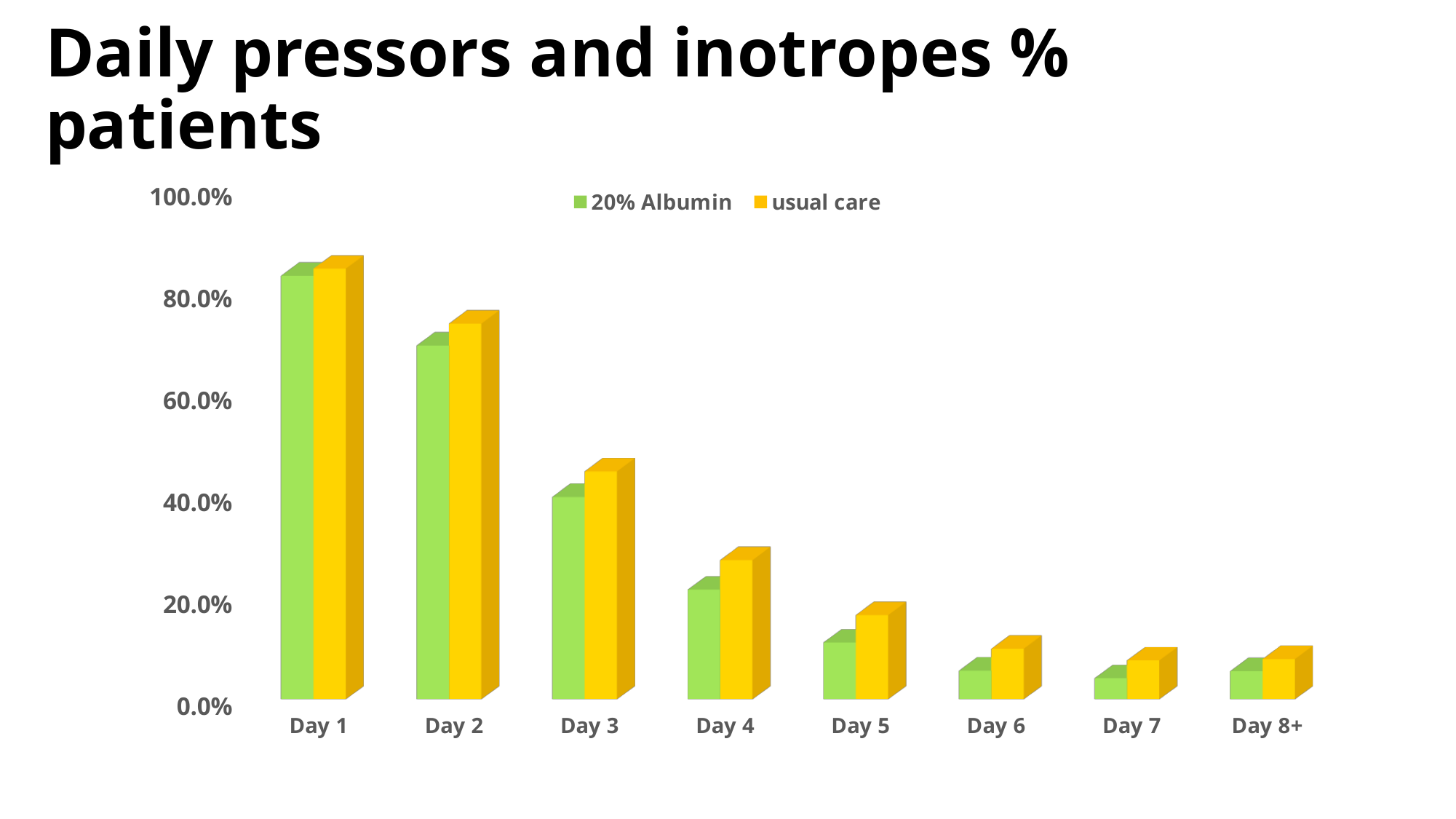
Is the usual care value for Day 4 greater or less than 40.0%? less On Day 4, which series has the larger value, 20% Albumin or usual care? usual care How many series does the legend list? 2 Is the 20% Albumin value for Day 3 greater or less than 60.0%? less Is the usual care value for Day 2 greater or less than 60.0%? greater Which day has the highest value for the usual care series? Day 1 Which day has the highest value for the 20% Albumin series? Day 1 What kind of chart is shown on the slide? bar chart Do the values rise or fall from Day 1 to Day 8+? fall How many day categories are shown on the x axis? 8